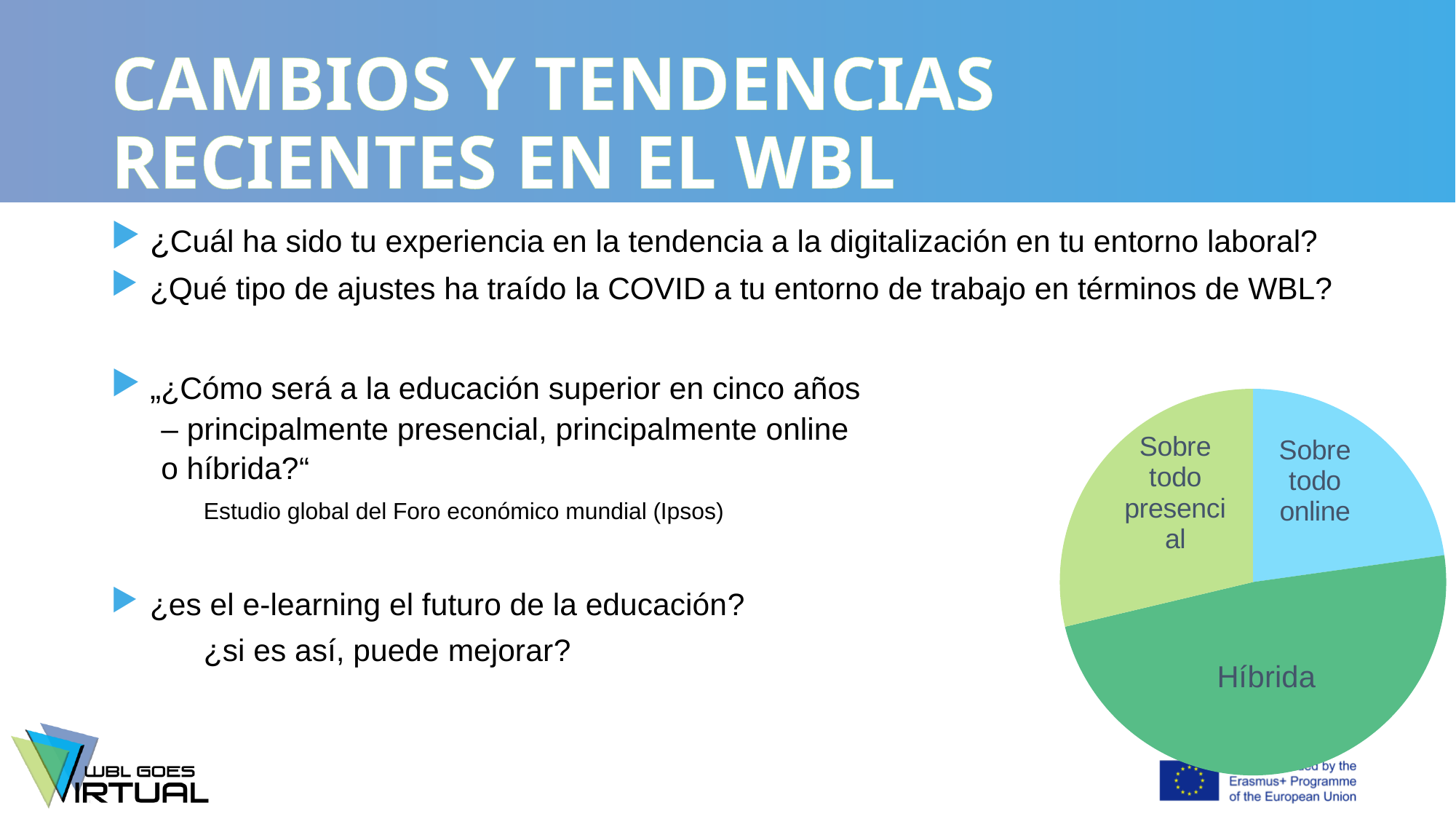
Which is larger in the pie chart, Híbrida or Sobre todo online? Híbrida How many slices does the pie chart have? 3 What kind of chart is shown on the slide? pie chart What colour is the Híbrida slice of the pie chart? green Which slice of the pie chart is the largest? Híbrida Which slice of the pie chart is light blue? Sobre todo online